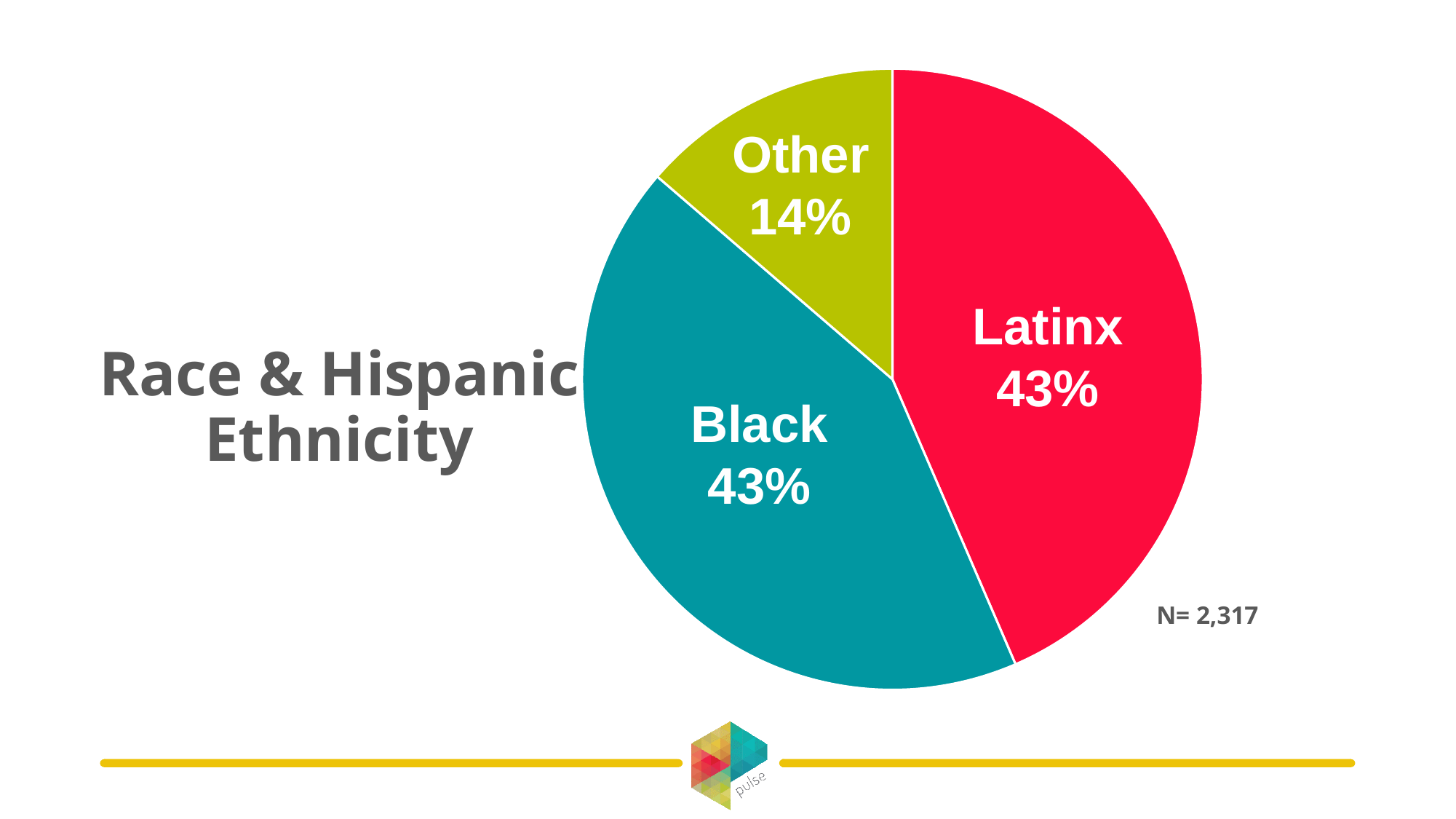
What percentage of the pie is labelled Other? 14% What is the combined share of the Latinx and Black slices? 86% What is the title of the chart? Race & Hispanic Ethnicity What percentage of the pie is labelled Latinx? 43% Which is larger, the Black slice or the Other slice? Black What percentage of the pie is labelled Black? 43% How many slices does the pie chart have? 3 What is the difference in percentage points between the Latinx slice and the Other slice? 29 Which category has the smallest share of the pie? Other What type of chart is shown on the slide? pie chart What sample size (N) is shown on the slide? N= 2,317